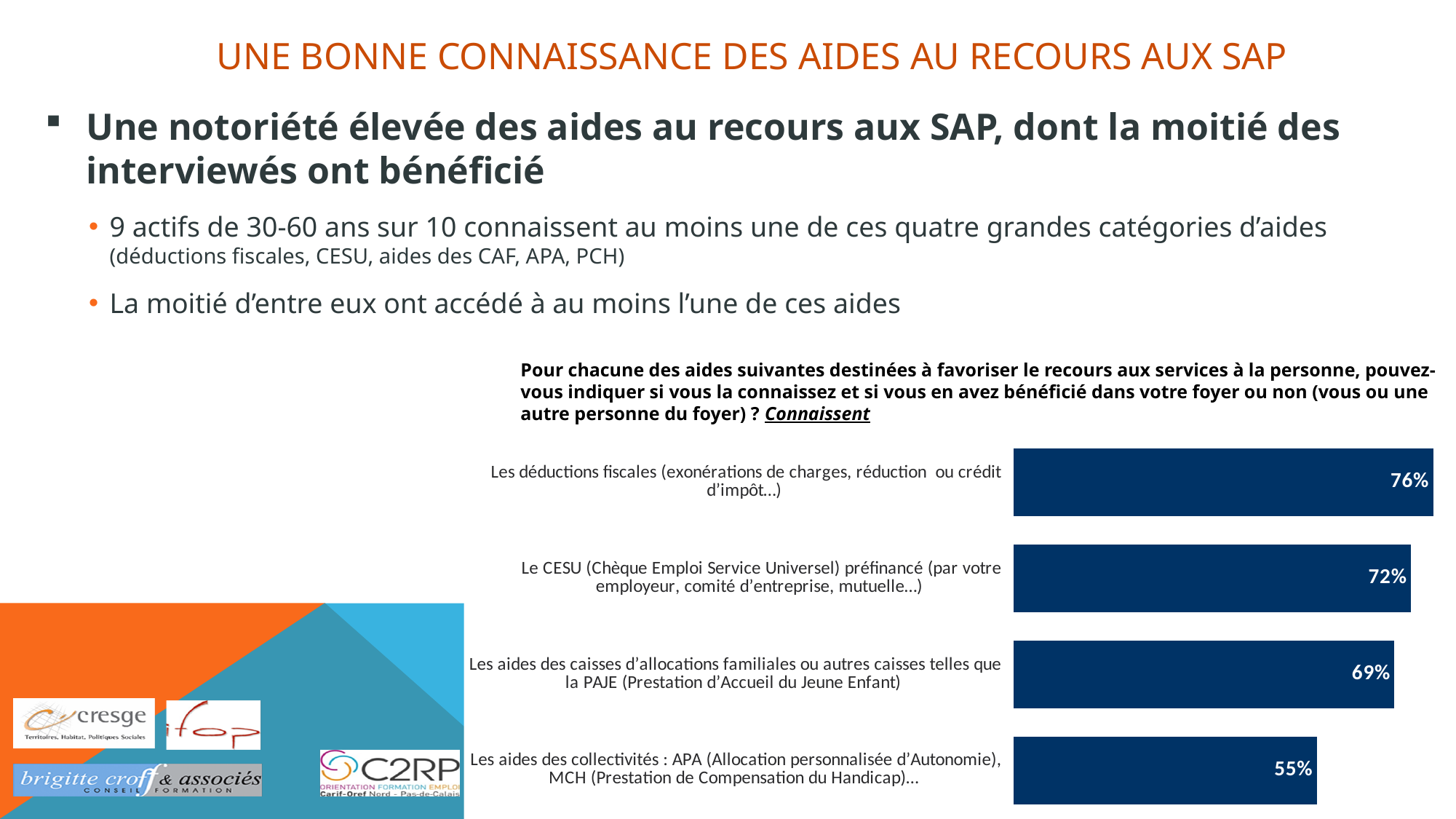
What is the difference in percentage points between the value for 'Les déductions fiscales' and the value for 'Les aides des collectivités'? 21 Which word is underlined at the end of the chart's question text? Connaissent Which aid has the lowest share of respondents who know it? Les aides des collectivités : APA (Allocation personnalisée d'Autonomie), MCH (Prestation de Compensation du Handicap)… Which is larger: the value for 'Le CESU préfinancé' or the value for 'Les aides des collectivités'? Le CESU préfinancé What percentage of respondents know 'Le CESU (Chèque Emploi Service Universel) préfinancé'? 72% How many aid categories are shown in the chart? 4 What type of chart is used on the slide? Bar chart What is the difference in percentage points between the value for 'Le CESU préfinancé' and the value for 'Les aides des caisses d'allocations familiales'? 3 Which aid has the highest share of respondents who know it? Les déductions fiscales (exonérations de charges, réduction ou crédit d'impôt…) What is the value shown for 'Les aides des collectivités : APA, MCH…'? 55% What percentage of respondents know 'Les déductions fiscales (exonérations de charges, réduction ou crédit d'impôt…)'? 76% What is the value shown for 'Les aides des caisses d'allocations familiales ou autres caisses telles que la PAJE'? 69%